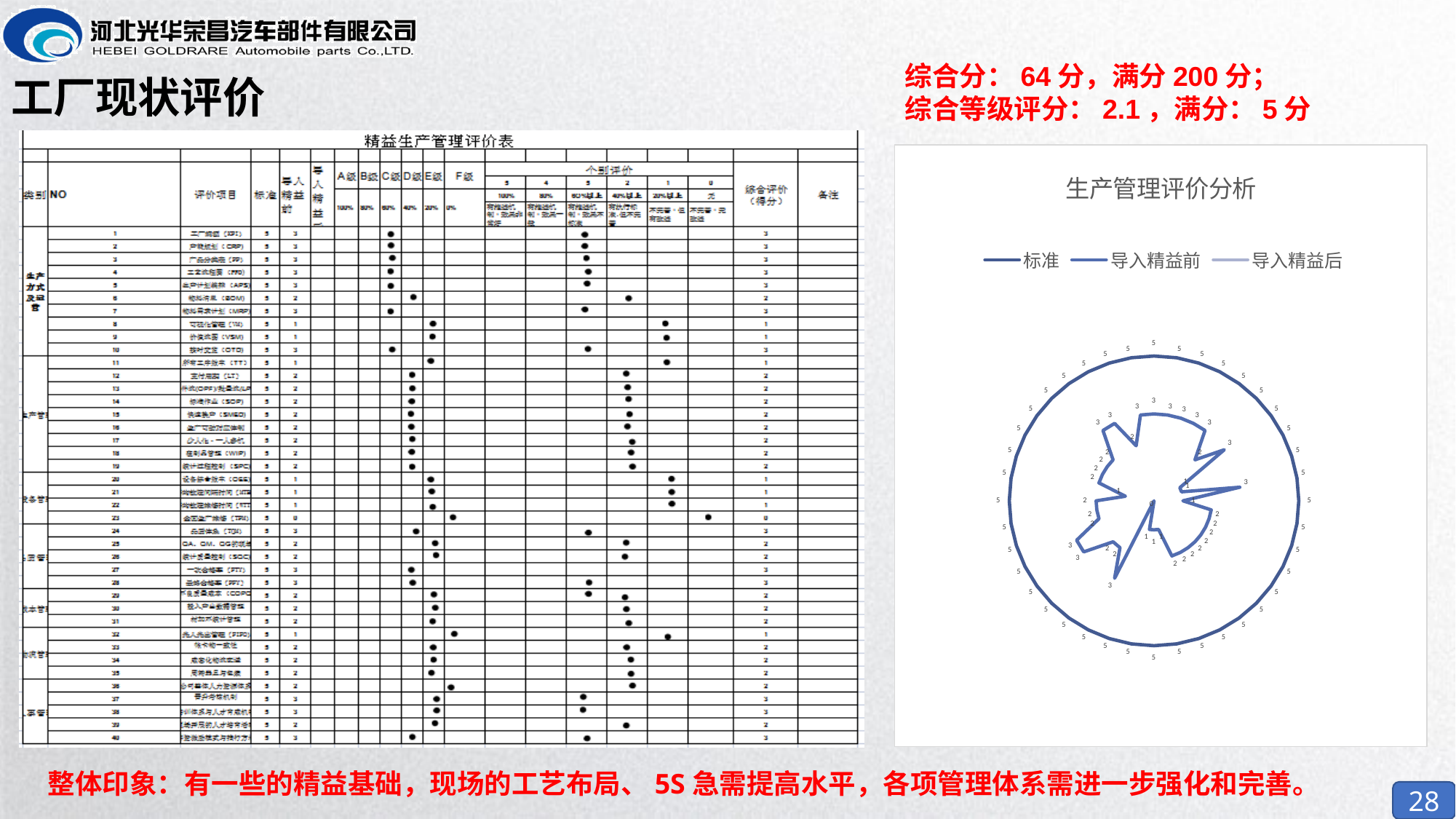
What is the title of the chart on the right side of the slide? 生产管理评价分析 How many series does the legend of the 生产管理评价分析 chart list? 3 What are the three legend entries of the 生产管理评价分析 chart? 标准, 导入精益前, 导入精益后 What kind of chart is shown on the right side of the slide under the title 生产管理评价分析? radar chart In the 生产管理评价分析 chart, what value does the 标准 series take at every point? 5 In the 生产管理评价分析 chart, what is the highest value labelled on the 导入精益前 series? 3 In the 生产管理评价分析 chart, is every value of the 导入精益前 series greater or less than 5? less In the 生产管理评价分析 chart, does the 标准 series rise, fall, or stay constant around the chart? stay constant In the 生产管理评价分析 chart, which series has larger values, 标准 or 导入精益前? 标准